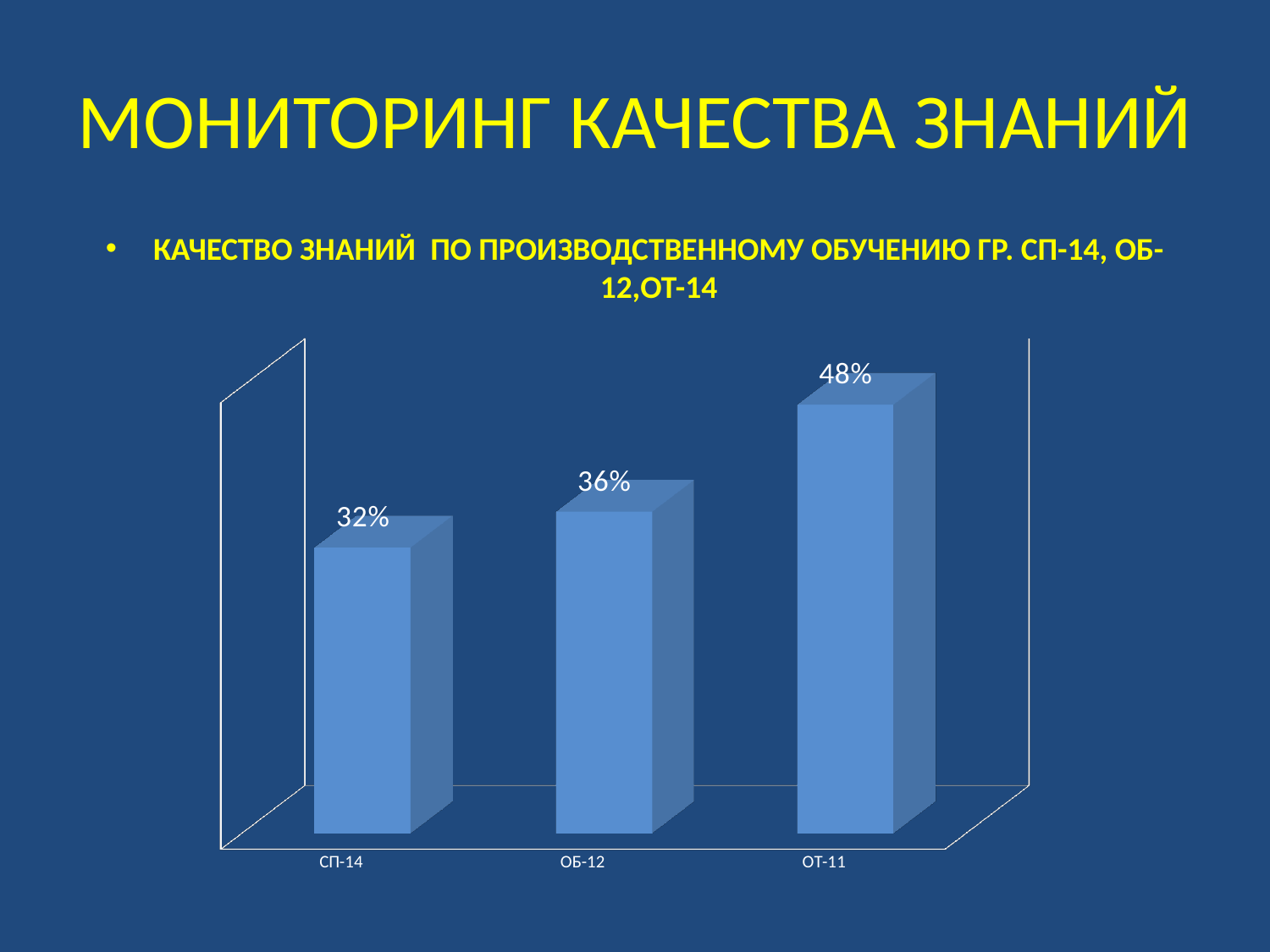
How many categories are shown on the x axis? 3 What is the value for ОТ-11? 48% What is the main title of the slide? МОНИТОРИНГ КАЧЕСТВА ЗНАНИЙ Which category has the lowest value? СП-14 What is the difference between the values for ОТ-11 and СП-14? 16% What is the value for СП-14? 32% What kind of chart is shown on the slide? bar chart Which is larger, the value for ОБ-12 or the value for ОТ-11? ОТ-11 What is the difference between the values for ОБ-12 and СП-14? 4% What is the value for ОБ-12? 36% Which category has the highest value? ОТ-11 Do the values rise or fall from left to right along the x axis? rise